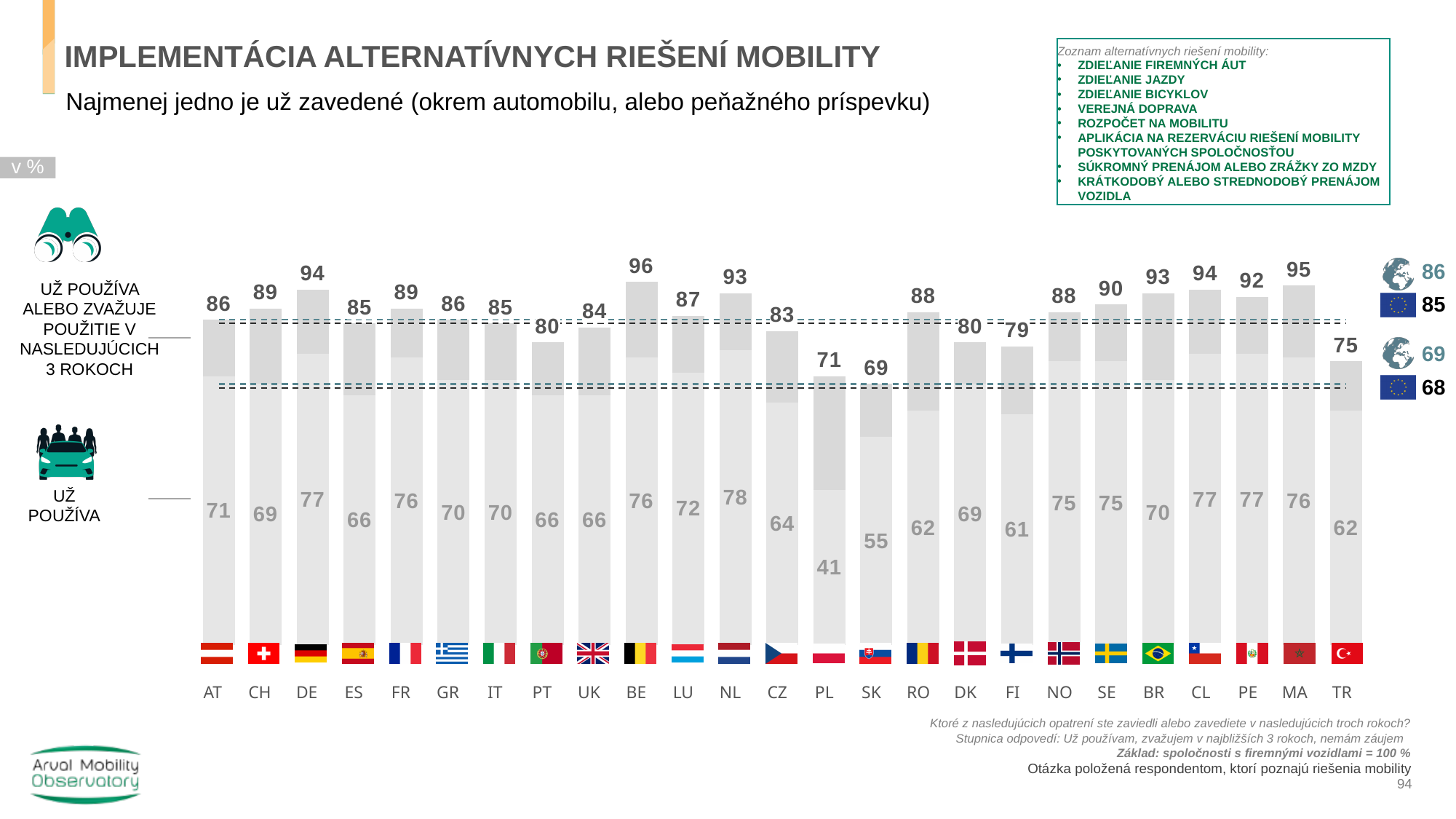
Which country has the highest value for 'UŽ POUŽÍVA ALEBO ZVAŽUJE POUŽITIE V NASLEDUJÚCICH 3 ROKOCH'? BE What is the value for 'UŽ POUŽÍVA' for PL? 41 What is the 'UŽ POUŽÍVA' value for SK? 55 How many countries are shown on the x axis of the chart? 25 What is the value for 'UŽ POUŽÍVA ALEBO ZVAŽUJE POUŽITIE V NASLEDUJÚCICH 3 ROKOCH' for NL? 93 What is the difference between the 'UŽ POUŽÍVA' values for DE and TR? 15 What kind of chart is shown on the slide? bar chart What is the global value shown for 'UŽ POUŽÍVA ALEBO ZVAŽUJE POUŽITIE V NASLEDUJÚCICH 3 ROKOCH' next to the globe icon? 86 Which country has the lowest value for 'UŽ POUŽÍVA ALEBO ZVAŽUJE POUŽITIE V NASLEDUJÚCICH 3 ROKOCH'? SK Which country has the lowest value for 'UŽ POUŽÍVA'? PL Which country has a higher 'UŽ POUŽÍVA' value, NL or CZ? NL What is the EU value shown for 'UŽ POUŽÍVA' next to the EU flag? 68